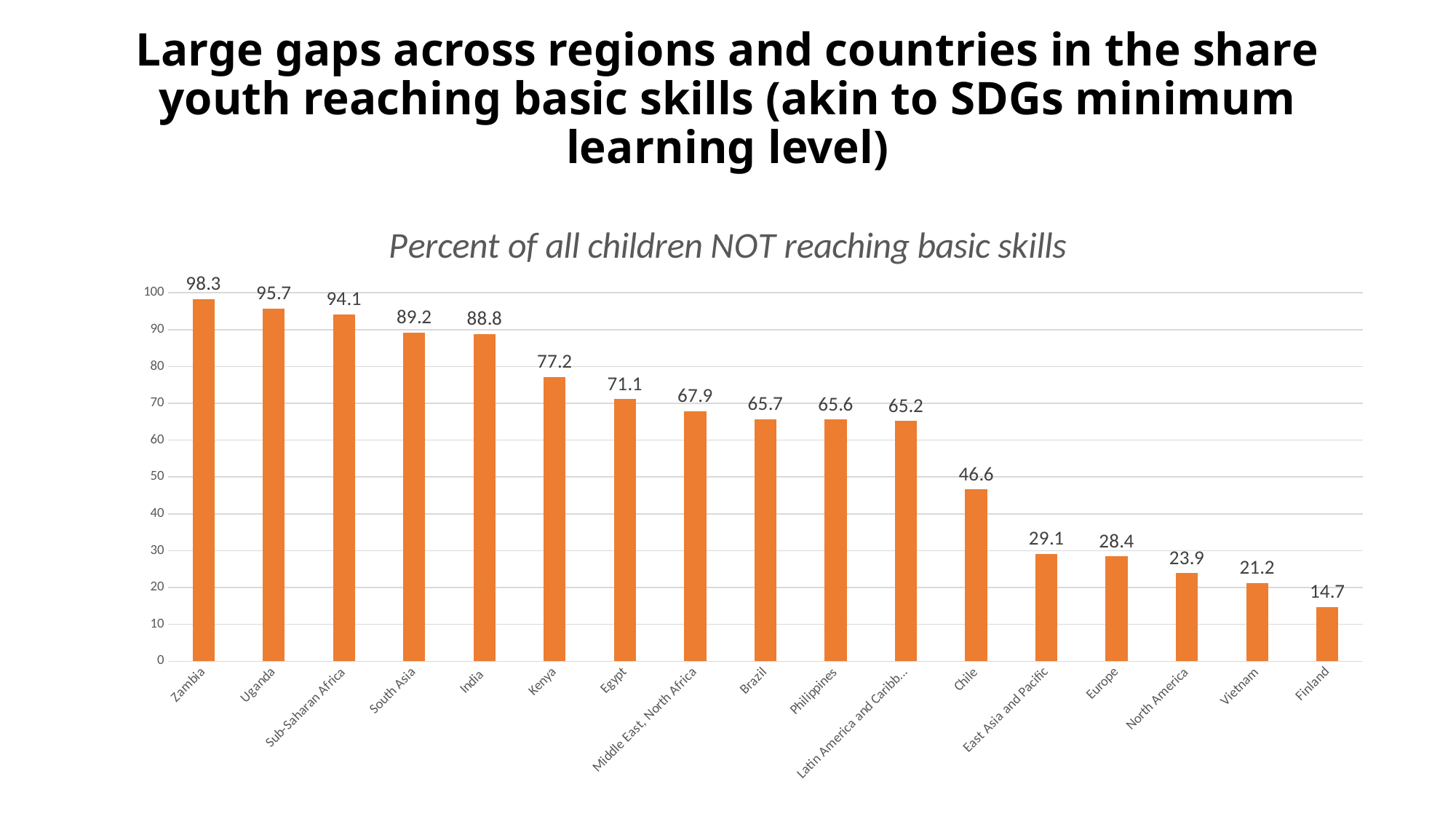
What is the value for Chile? 46.6 What is the value for Kenya? 77.2 How many categories are shown on the x axis? 17 What is the value for Zambia? 98.3 What is the difference between the values for Uganda and Finland? 81.0 What is the difference between the values for India and Egypt? 17.7 Which category has the highest value? Zambia Which category has the lowest value? Finland Which is larger, the value for Brazil or the value for Chile? Brazil What is the title of the chart? Percent of all children NOT reaching basic skills What is the value for Vietnam? 21.2 What kind of chart is shown on the slide? Bar chart